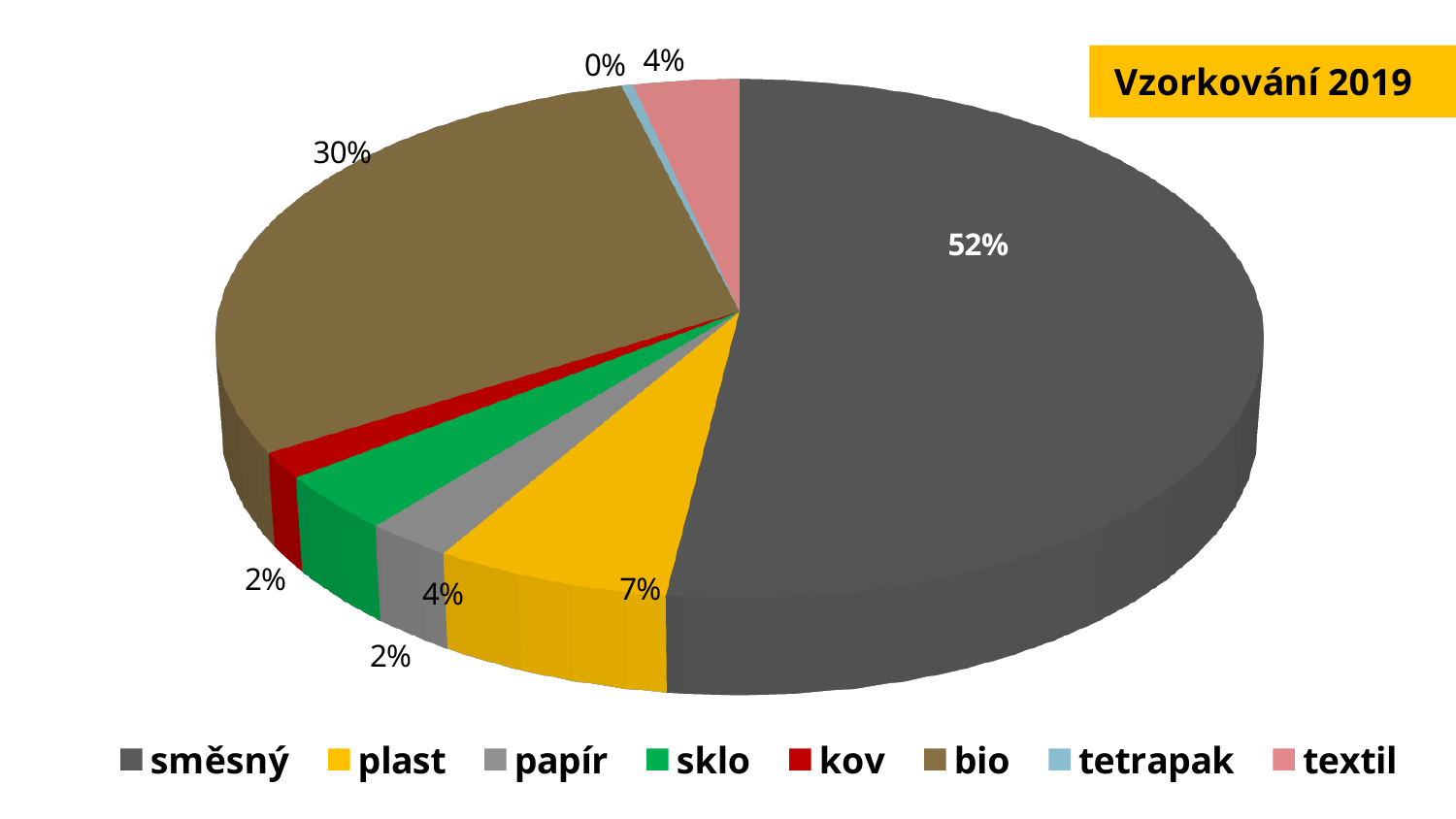
Which category has the smallest slice of the pie? tetrapak What share of the pie does směsný have? 52% How many categories does the legend list? 8 What share of the pie does textil have? 4% Which category has the largest slice of the pie? směsný What kind of chart is shown on the slide? pie chart What share of the pie does bio have? 30% What share of the pie does tetrapak have? 0% What is the text in the yellow box in the top right corner of the slide? Vzorkování 2019 Which is larger, the slice for plast or the slice for papír? plast What is the difference in percentage points between směsný and bio? 22 What share of the pie does plast have? 7%